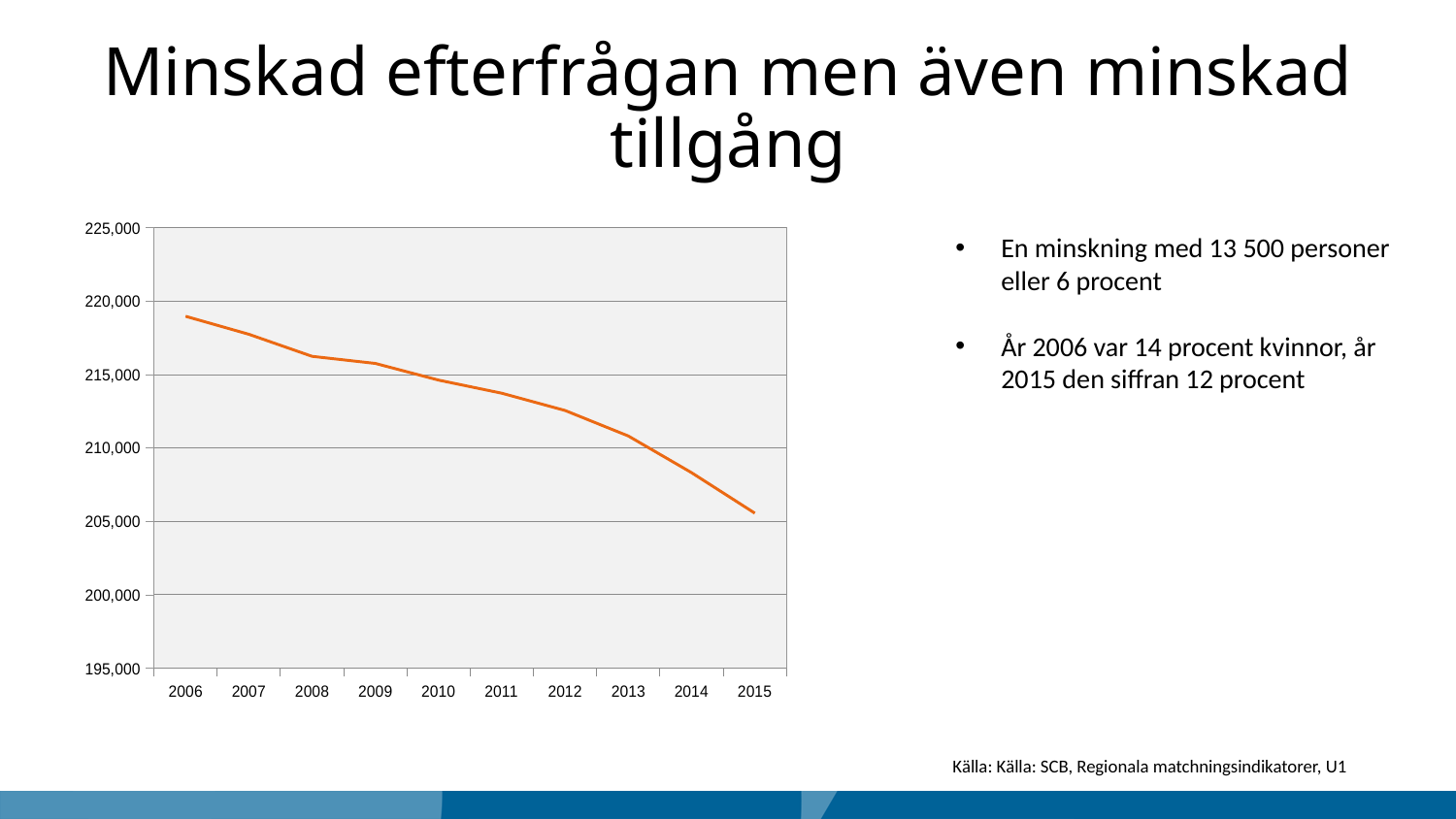
Is the value for 2012 greater or less than 210,000? greater Which year has the larger value, 2007 or 2013? 2007 Is the value for 2014 greater or less than 210,000? less What kind of chart is shown on the slide? line chart Which year has the highest value in the chart? 2006 Is the value for 2015 greater or less than 210,000? less Which year has the lowest value in the chart? 2015 Do the values in the chart rise or fall from 2006 to 2015? fall How many years are plotted on the x axis of the chart? 10 What is the lowest value shown on the y axis of the chart? 195,000